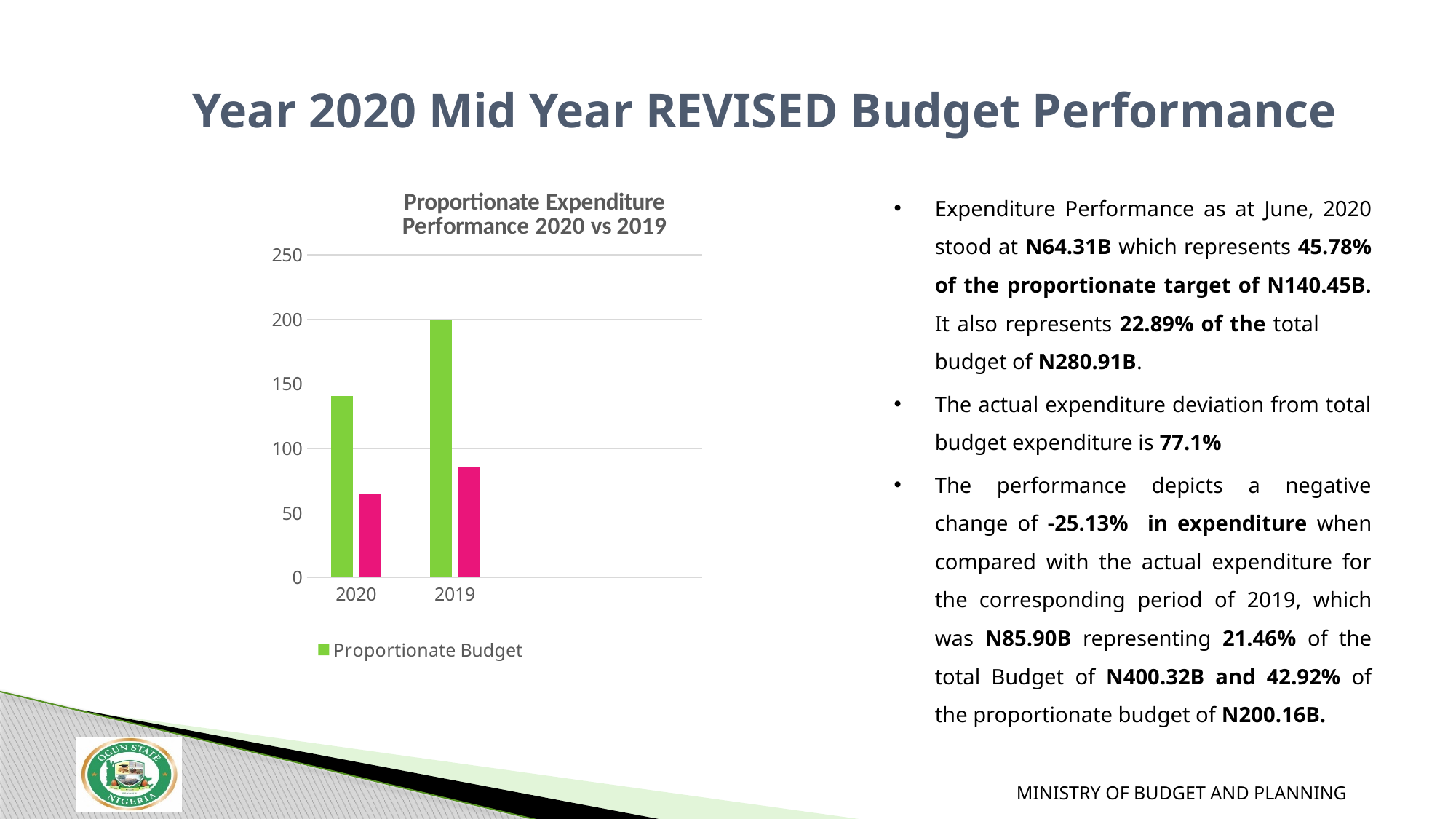
Which year has the taller pink bar, 2020 or 2019? 2019 Which category has the tallest bar in the chart? 2019 What series name appears in the chart's legend? Proportionate Budget How many categories are shown on the x axis of the chart? 2 Which year has the higher Proportionate Budget (green bar), 2020 or 2019? 2019 Is the Proportionate Budget (green) value for 2019 greater or less than 150? greater Is the Proportionate Budget (green) value for 2020 greater or less than 100? greater How many series does the chart's legend list? 1 Is the pink bar value for 2019 greater or less than 100? less What kind of chart is shown on the slide? bar chart What is the title of the chart? Proportionate Expenditure Performance 2020 vs 2019